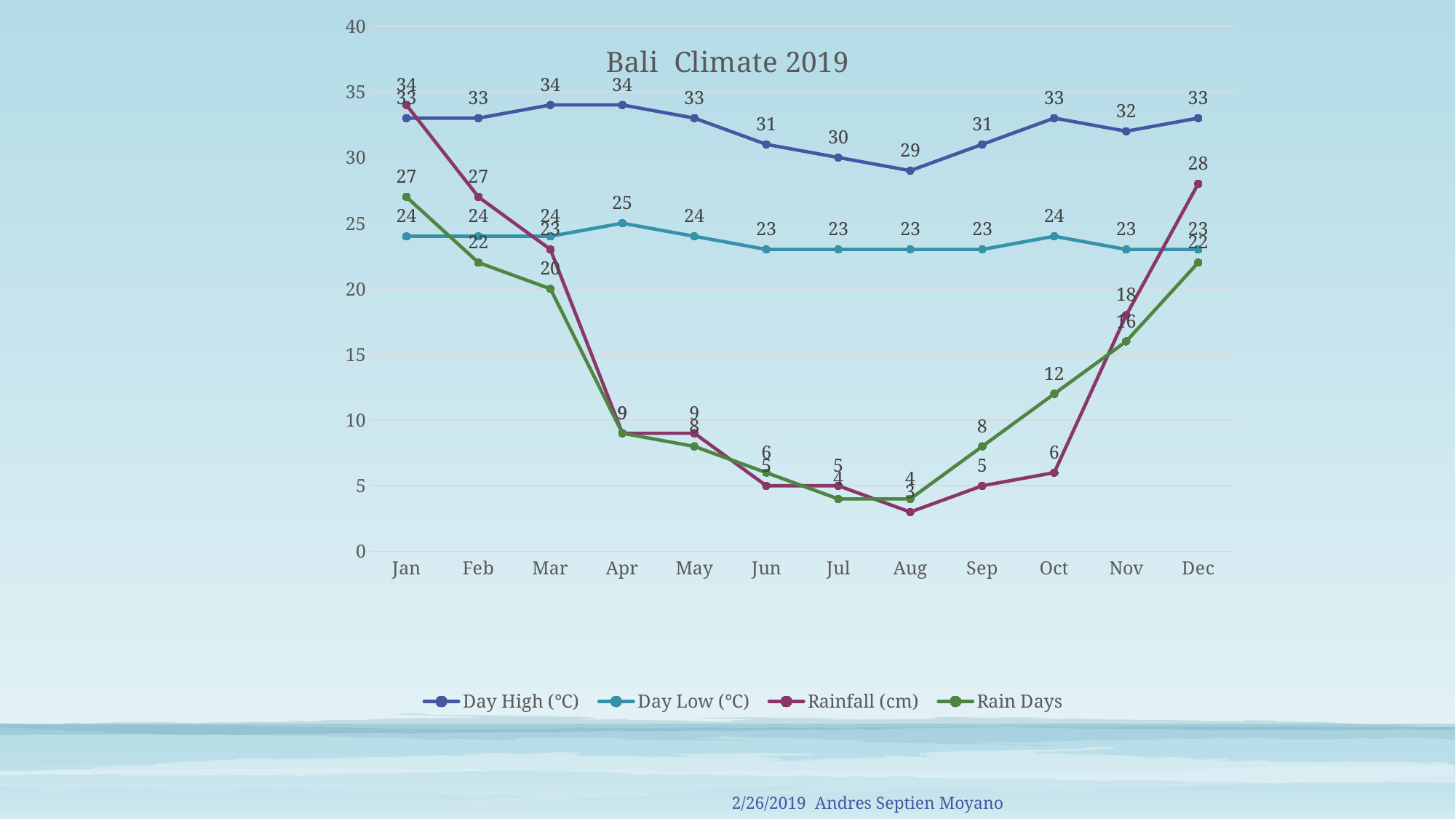
What is the Rainfall (cm) value for Nov? 18 What kind of chart is shown on the slide? Line chart Does the Rainfall (cm) series rise or fall from Jan to Apr? Fall How many months are plotted on the x axis? 12 Which month has the lowest Day High (°C)? Aug What is the difference between the Rainfall (cm) values for Dec and Aug? 25 Which is larger, the Rain Days value for Feb or for Dec? They are equal (22) What is the Rain Days value for Oct? 12 What is the Day Low (°C) value for Apr? 25 What is the Day High (°C) value for Aug? 29 Which month has the highest Rainfall (cm)? Jan How many series does the legend list? 4